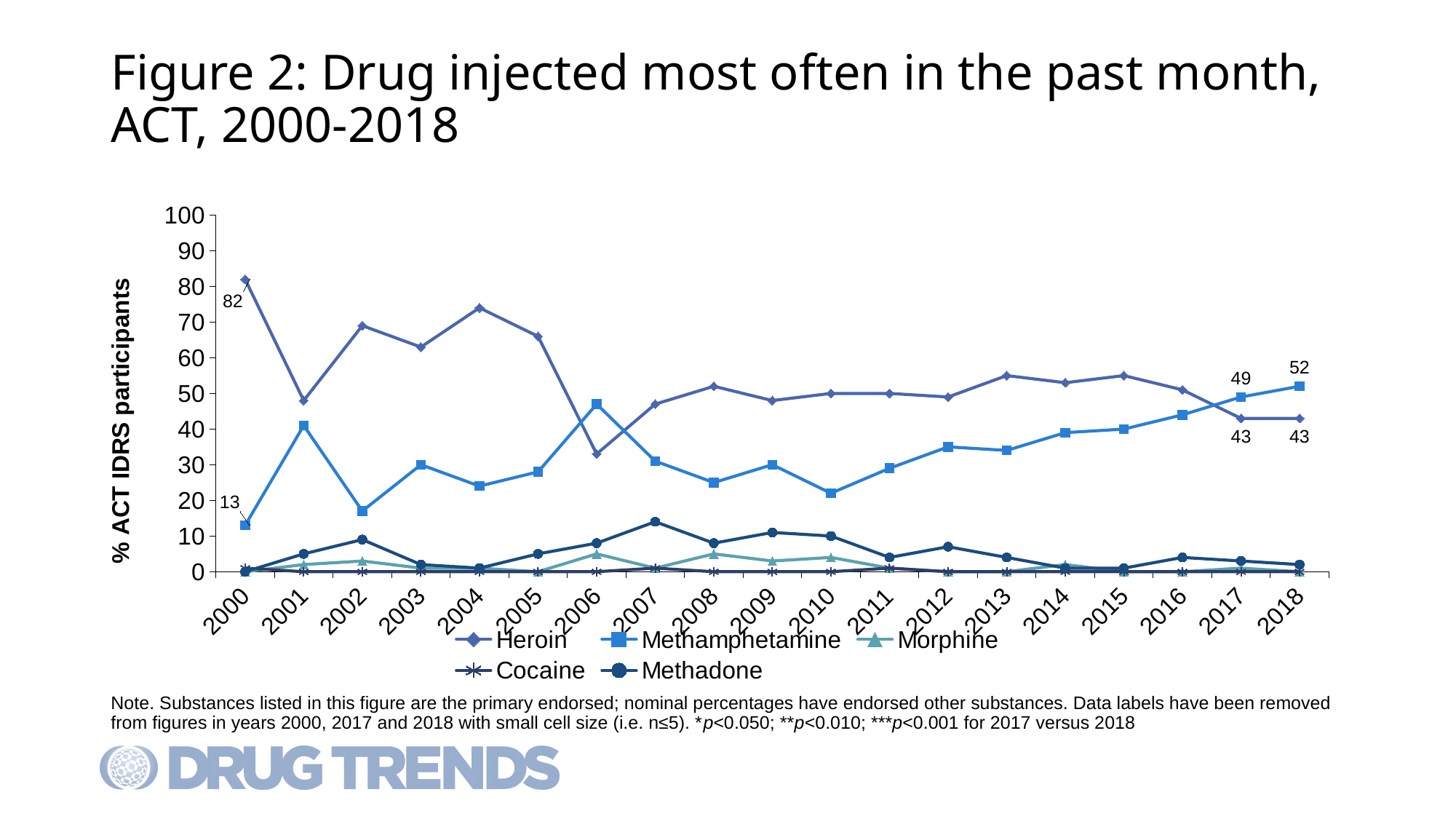
How many series does the legend list? 5 In 2018, which is larger: the Heroin value or the Methamphetamine value? Methamphetamine What is the value for Heroin in 2017? 43 Is the value for Methamphetamine in 2010 greater or less than 30? less What kind of chart is shown on the slide? Line chart In which year is the Heroin value highest? 2000 What is the value for Methamphetamine in 2000? 13 What is the value for Methamphetamine in 2018? 52 By how much did the Methamphetamine value increase from 2017 to 2018? 3 What percentage of ACT IDRS participants reported heroin as the drug injected most often in 2000? 82 What is the difference between the Heroin and Methamphetamine values in 2000? 69 Is the value for Heroin in 2004 greater or less than 70? greater